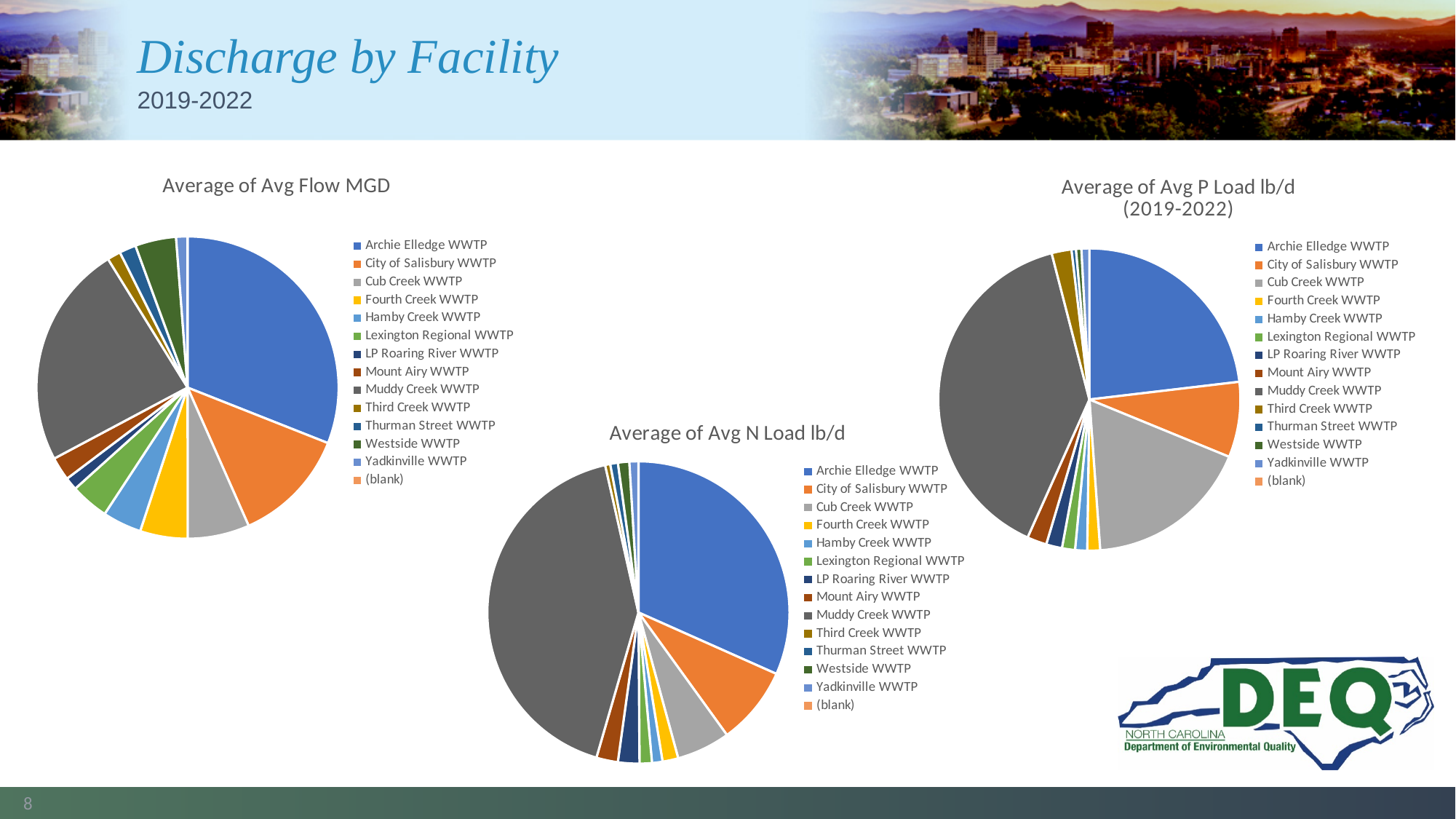
In the "Average of Avg P Load lb/d (2019-2022)" chart, which slice is larger: Archie Elledge WWTP or Cub Creek WWTP? Archie Elledge WWTP In the "Average of Avg N Load lb/d" chart, which slice is larger: Archie Elledge WWTP or Cub Creek WWTP? Archie Elledge WWTP How many pie charts are shown on the slide? 3 In the "Average of Avg Flow MGD" chart, which slice is larger: City of Salisbury WWTP or Cub Creek WWTP? City of Salisbury WWTP In the "Average of Avg P Load lb/d (2019-2022)" chart, which facility has the largest slice? Muddy Creek WWTP How many categories does the legend of the "Average of Avg N Load lb/d" chart list? 14 What kind of chart is "Average of Avg Flow MGD"? pie chart In the "Average of Avg N Load lb/d" chart, which facility has the largest slice? Muddy Creek WWTP What is the title of the middle chart on the slide? Average of Avg N Load lb/d In the "Average of Avg P Load lb/d (2019-2022)" chart, what colour represents Archie Elledge WWTP? blue